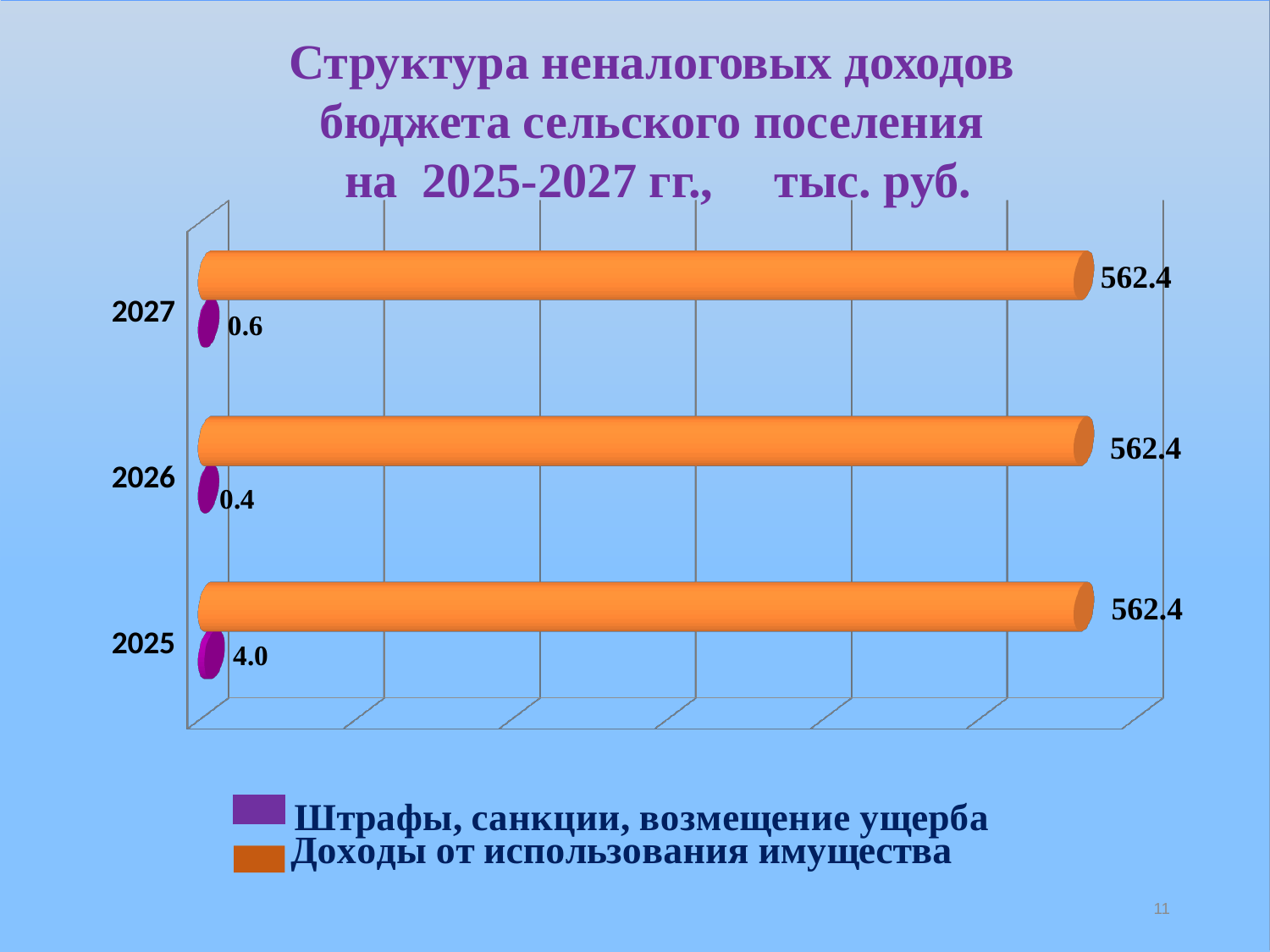
What is the value for "Штрафы, санкции, возмещение ущерба" in 2025? 4.0 Which colour represents "Доходы от использования имущества" in the chart? Orange In which year is the value for "Штрафы, санкции, возмещение ущерба" lowest? 2026 Which is larger in 2026: "Доходы от использования имущества" or "Штрафы, санкции, возмещение ущерба"? Доходы от использования имущества What is the value for "Доходы от использования имущества" in 2025? 562.4 How many years are shown on the chart? 3 What is the value for "Штрафы, санкции, возмещение ущерба" in 2027? 0.6 What kind of chart is shown on the slide? Bar chart What is the difference between the "Штрафы, санкции, возмещение ущерба" values for 2025 and 2027? 3.4 How many series does the legend list? 2 In which year is the value for "Штрафы, санкции, возмещение ущерба" highest? 2025 What is the value for "Штрафы, санкции, возмещение ущерба" in 2026? 0.4